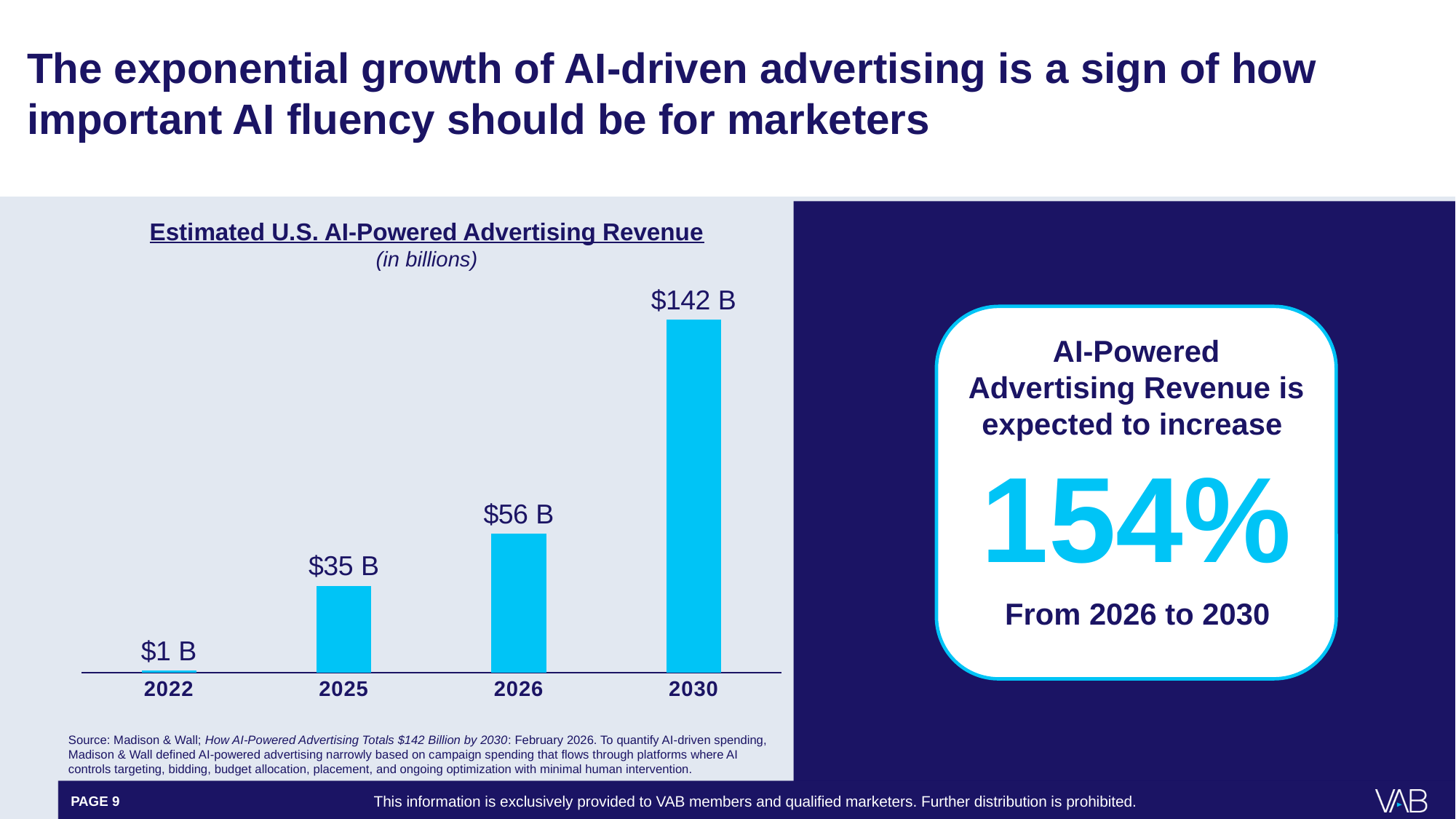
What is the estimated U.S. AI-powered advertising revenue for 2025? $35 B Which year has the lowest estimated AI-powered advertising revenue? 2022 What is the title of the chart? Estimated U.S. AI-Powered Advertising Revenue (in billions) Do the estimated revenue values rise or fall from 2022 to 2030? Rise What is the estimated U.S. AI-powered advertising revenue for 2022? $1 B What is the difference in estimated revenue between 2030 and 2026? $86 B How many years are shown on the chart? 4 What is the estimated U.S. AI-powered advertising revenue for 2026? $56 B What kind of chart is shown on the slide? Bar chart Which year has the larger estimated revenue, 2025 or 2026? 2026 What is the difference in estimated revenue between 2026 and 2025? $21 B Which year has the highest estimated AI-powered advertising revenue? 2030